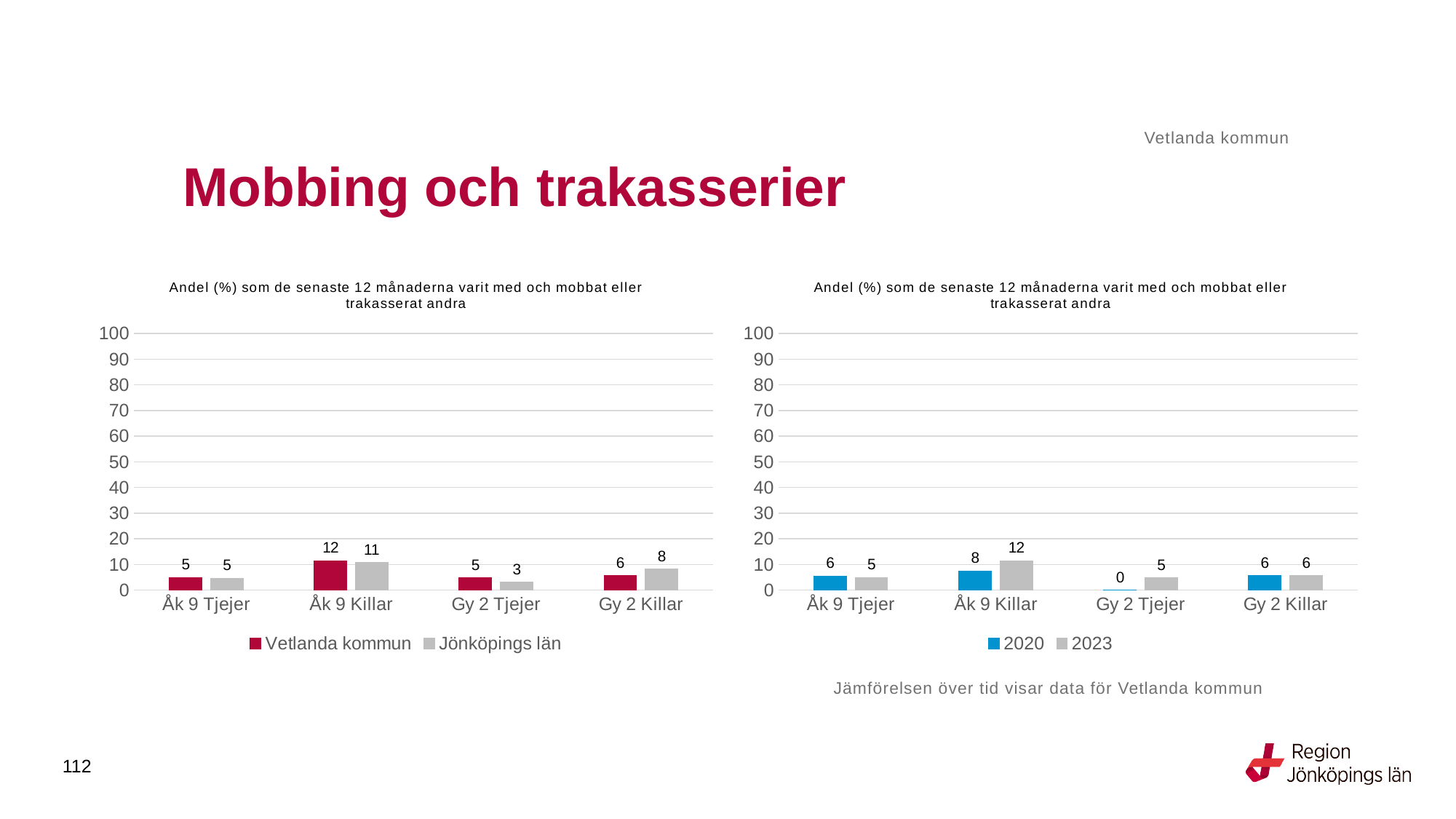
How many categories are shown on the x axis of the right chart? 4 In the left chart, which is larger for Gy 2 Tjejer: Vetlanda kommun or Jönköpings län? Vetlanda kommun What type of chart is the right chart? Bar chart In the left chart, what is the value for Jönköpings län for Gy 2 Tjejer? 3 In the left chart, what is the difference between Jönköpings län and Vetlanda kommun for Gy 2 Killar? 2 In the right chart, what is the value for 2023 for Åk 9 Killar? 12 In the left chart, which category has the highest value for Vetlanda kommun? Åk 9 Killar In the right chart, what is the difference between 2023 and 2020 for Åk 9 Killar? 4 How many series does the legend of the left chart list? 2 In the right chart, what is the value for 2020 for Gy 2 Tjejer? 0 In the right chart, which category has the lowest value for 2020? Gy 2 Tjejer In the left chart, what is the value for Vetlanda kommun for Åk 9 Killar? 12